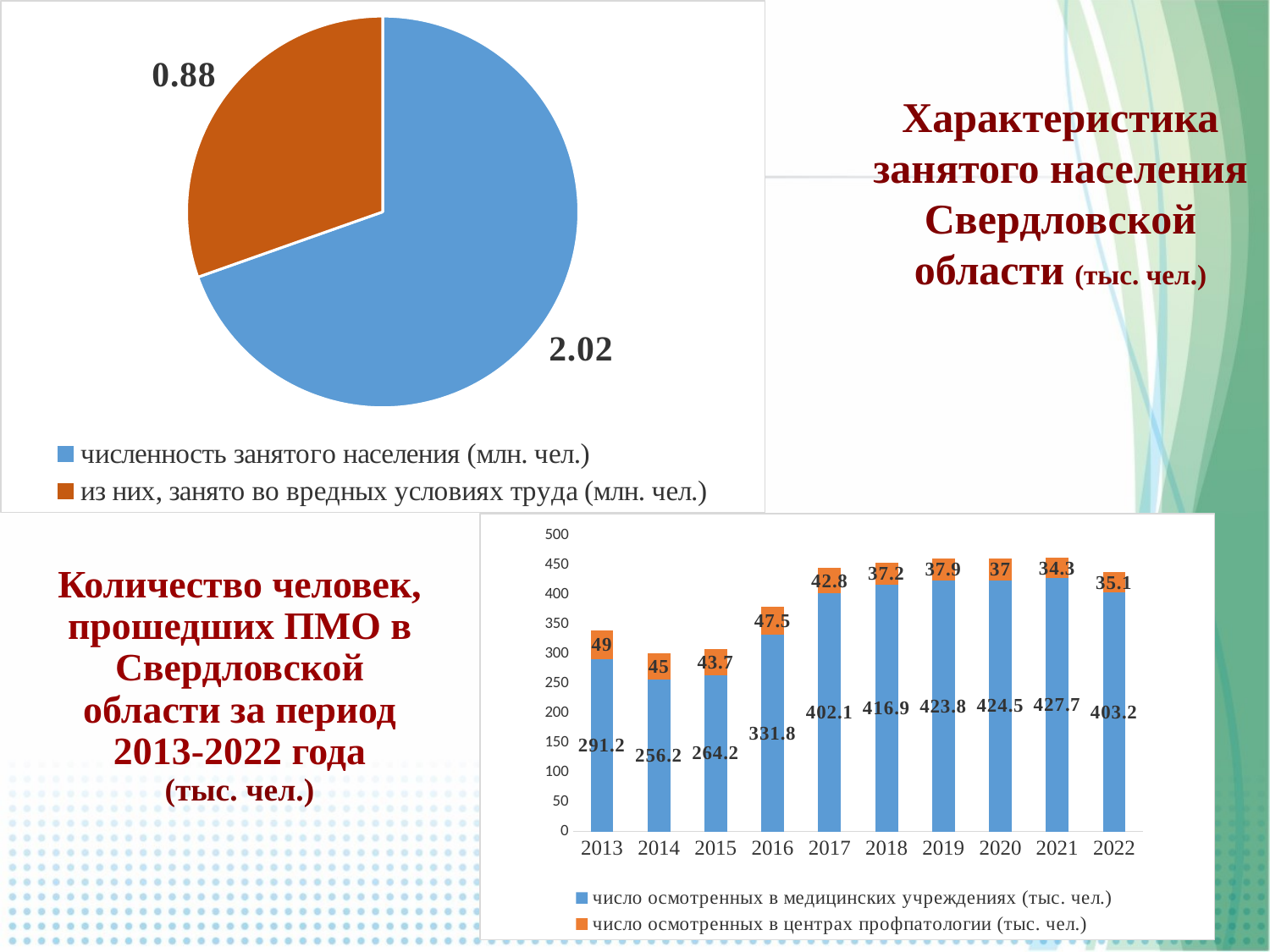
In the bar chart at the bottom, which is larger for число осмотренных в центрах профпатологии: 2016 or 2017? 2016 In the bar chart at the bottom, how many years are shown on the x axis? 10 In the bar chart at the bottom, do the values for число осмотренных в медицинских учреждениях rise or fall from 2016 to 2021? rise In the bar chart at the bottom, what is the value for число осмотренных в медицинских учреждениях in 2017? 402.1 In the bar chart at the bottom, which year has the highest value for число осмотренных в медицинских учреждениях? 2021 In the bar chart at the bottom, what is the value for число осмотренных в центрах профпатологии in 2013? 49 What kind of chart is the top-left chart on the slide? pie chart In the bar chart at the bottom, what is the difference between the 2021 and 2022 values for число осмотренных в медицинских учреждениях? 24.5 In the bar chart at the bottom, which year has the lowest value for число осмотренных в медицинских учреждениях? 2014 In the pie chart, what is the value for численность занятого населения (млн. чел.)? 2.02 In the bar chart at the bottom, what is the total of the stacked bar for 2013? 340.2 In the pie chart, what is the value for из них, занято во вредных условиях труда (млн. чел.)? 0.88